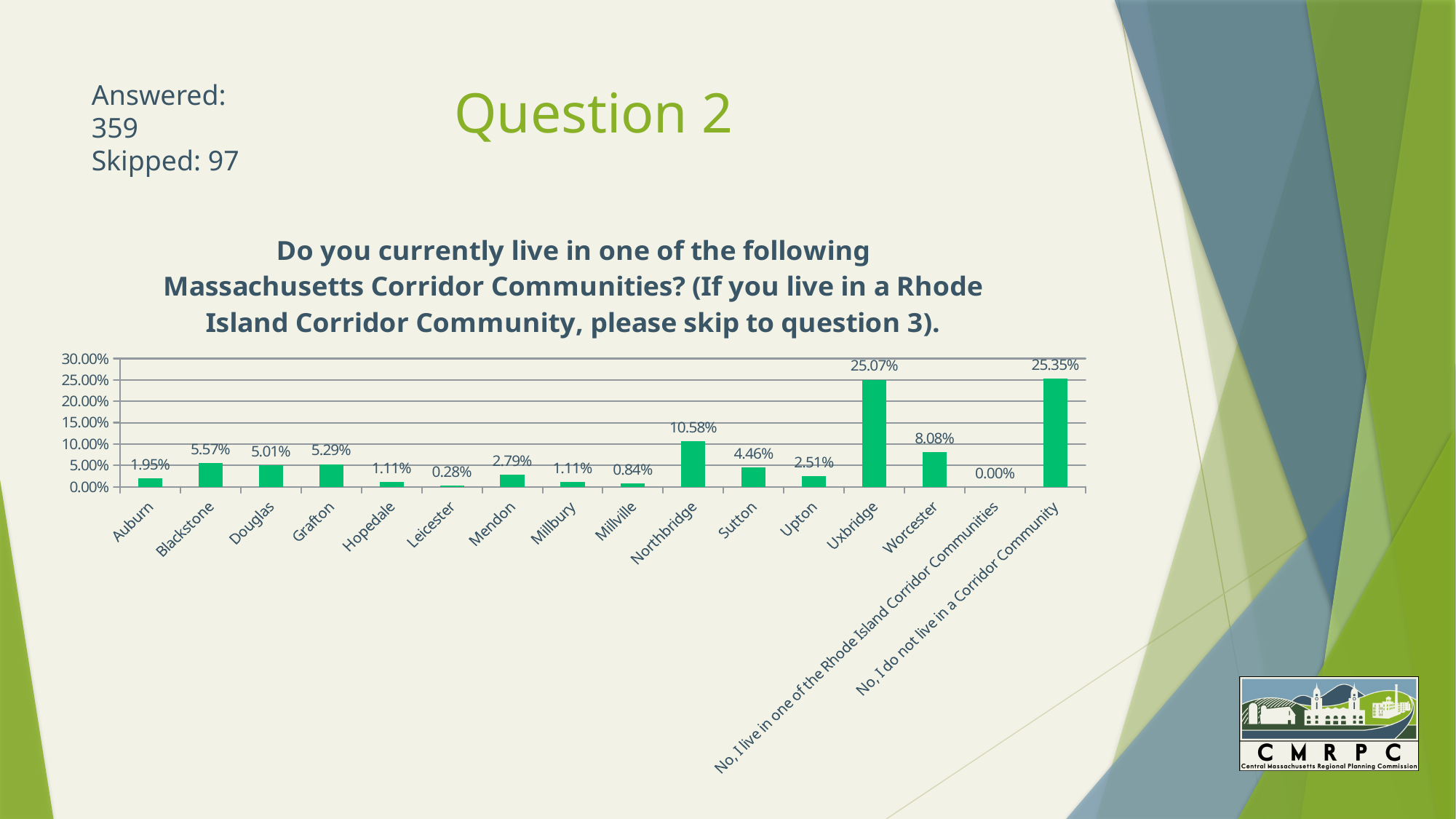
Which response option has the lowest percentage? No, I live in one of the Rhode Island Corridor Communities What percentage of respondents live in Uxbridge? 25.07% What percentage of respondents live in Leicester? 0.28% Which has a higher percentage, Grafton or Sutton? Grafton What percentage of respondents live in Northbridge? 10.58% What kind of chart is shown on the slide? Bar chart What percentage of respondents live in Worcester? 8.08% How many response categories are shown on the x axis? 16 What is the difference between the percentages for Blackstone and Douglas? 0.56% Which response option has the highest percentage? No, I do not live in a Corridor Community What is the highest value shown on the y axis? 30.00% Is the value for Northbridge greater or less than 10.00%? greater